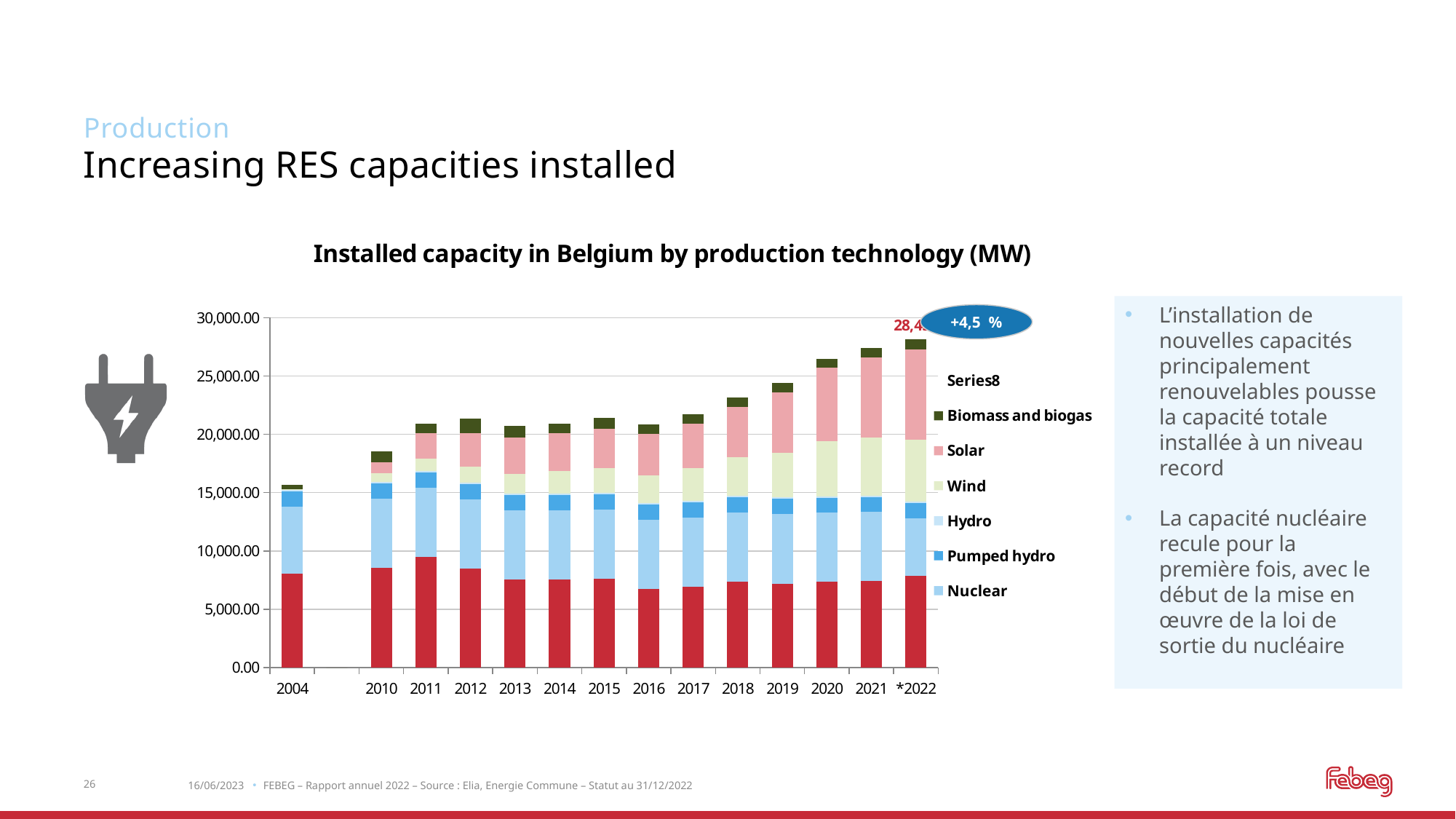
Is the total installed capacity for 2010 greater or less than 20,000.00? less Which year has the highest total installed capacity? *2022 Is the total installed capacity for 2004 greater or less than 20,000.00? less Which year has the lowest total installed capacity? 2004 What is the title of the chart? Installed capacity in Belgium by production technology (MW) What kind of chart is shown on the slide? Stacked bar chart Which year has a larger total installed capacity, 2016 or 2020? 2020 How many entries does the chart legend list? 7 Is the total installed capacity for *2022 greater or less than 25,000.00? greater What percentage change is shown in the blue oval annotation near the *2022 bar? +4,5 % Does the total installed capacity generally rise or fall from 2016 to *2022? rise How many years are shown on the x axis of the chart? 14